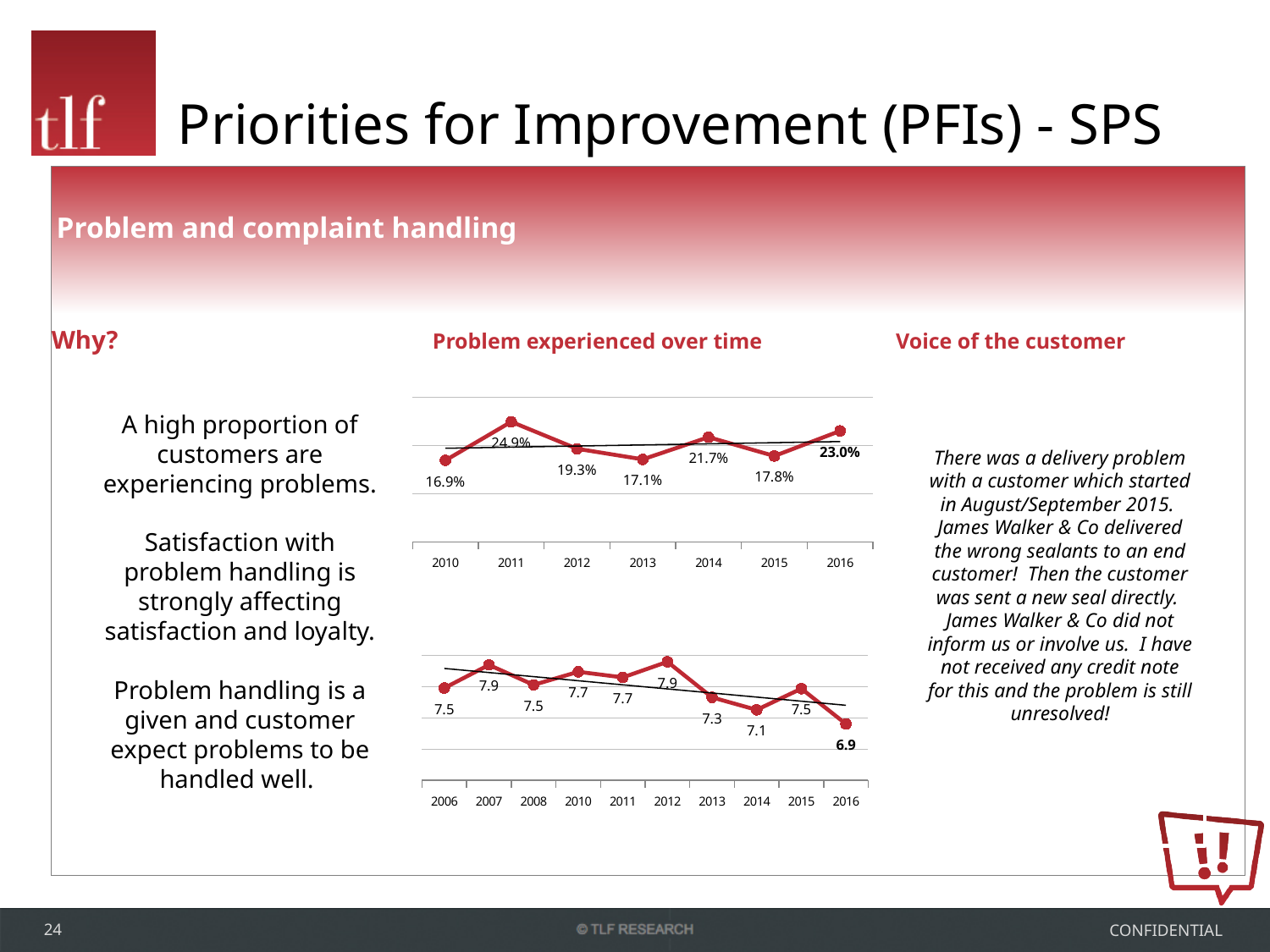
In the top chart titled 'Problem experienced over time', what is the difference between the 2011 value and the 2010 value? 8.0% In the lower chart on the slide, what is the value for 2014? 7.1 In the lower chart on the slide, how many years are plotted? 10 In the lower chart on the slide, what is the value for 2016? 6.9 In the lower chart on the slide, which year has the lowest value? 2016 What kind of chart is the top chart titled 'Problem experienced over time'? Line chart In the top chart titled 'Problem experienced over time', how many years are plotted? 7 In the lower chart on the slide, is the value for 2012 larger or smaller than the value for 2013? Larger In the top chart titled 'Problem experienced over time', which year has the highest value? 2011 In the top chart titled 'Problem experienced over time', what is the value for 2016? 23.0% In the top chart titled 'Problem experienced over time', which year has the lowest value? 2010 In the top chart titled 'Problem experienced over time', what is the value for 2010? 16.9%